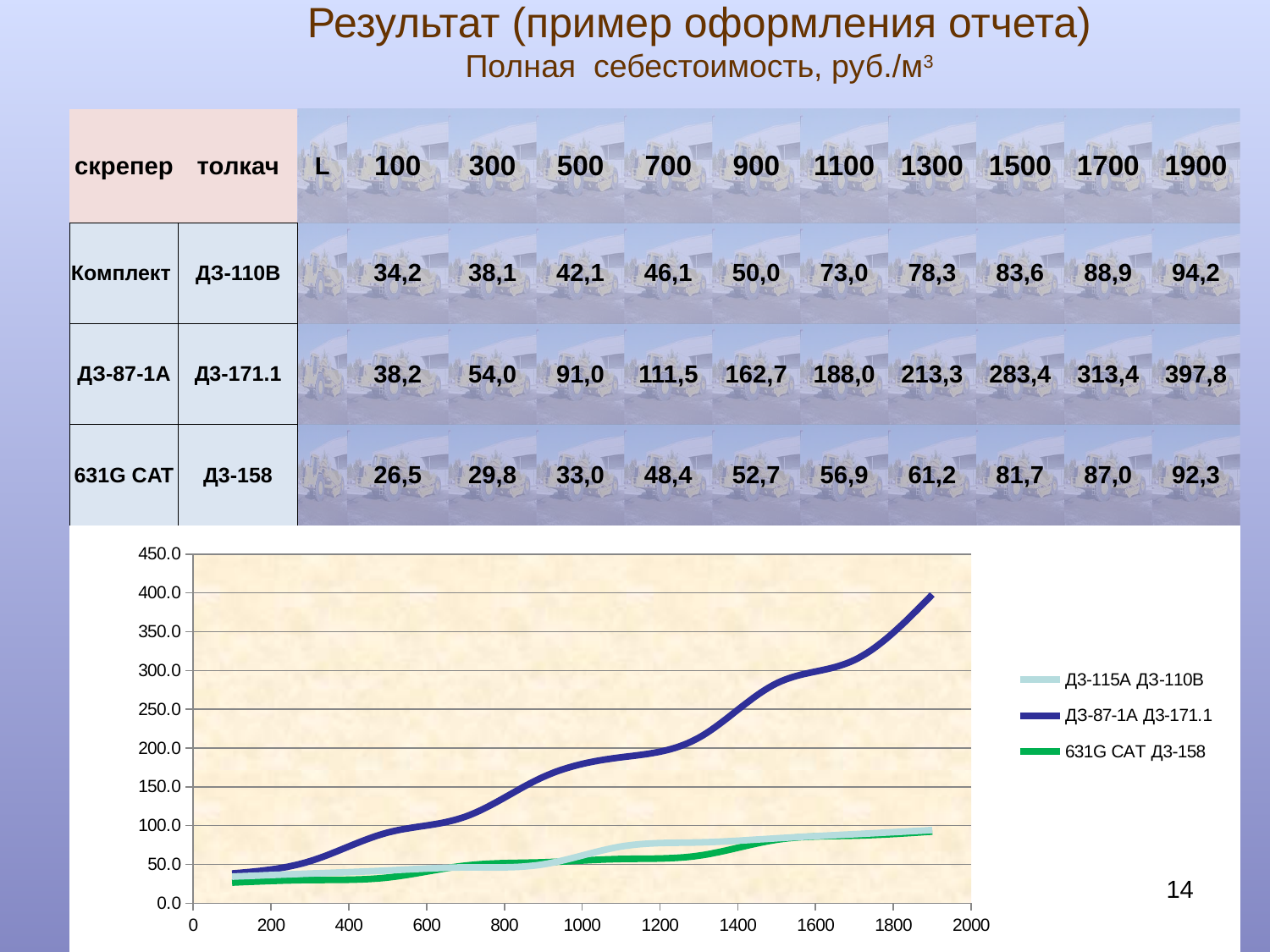
How many series does the chart legend list? 3 Is the value of the ДЗ-87-1А ДЗ-171.1 series at L = 1900 greater or less than 350? greater At L = 1900, which series has the larger value: ДЗ-87-1А ДЗ-171.1 or 631G CAT ДЗ-158? ДЗ-87-1А ДЗ-171.1 Is the value of the 631G CAT ДЗ-158 series at L = 100 greater or less than 50? less According to the table on the slide, what is the full cost for ДЗ-87-1А with ДЗ-171.1 at L = 1900? 397,8 What kind of chart is shown at the bottom of the slide? line chart Is the value of the ДЗ-115А ДЗ-110В series at L = 1900 greater or less than 100? less Which series reaches the highest value on the chart? ДЗ-87-1А ДЗ-171.1 According to the table on the slide, what is the full cost for 631G CAT with ДЗ-158 at L = 100? 26,5 Do the values of the ДЗ-87-1А ДЗ-171.1 series rise or fall as L increases along the x axis? rise What is the highest tick value shown on the chart's vertical axis? 450.0